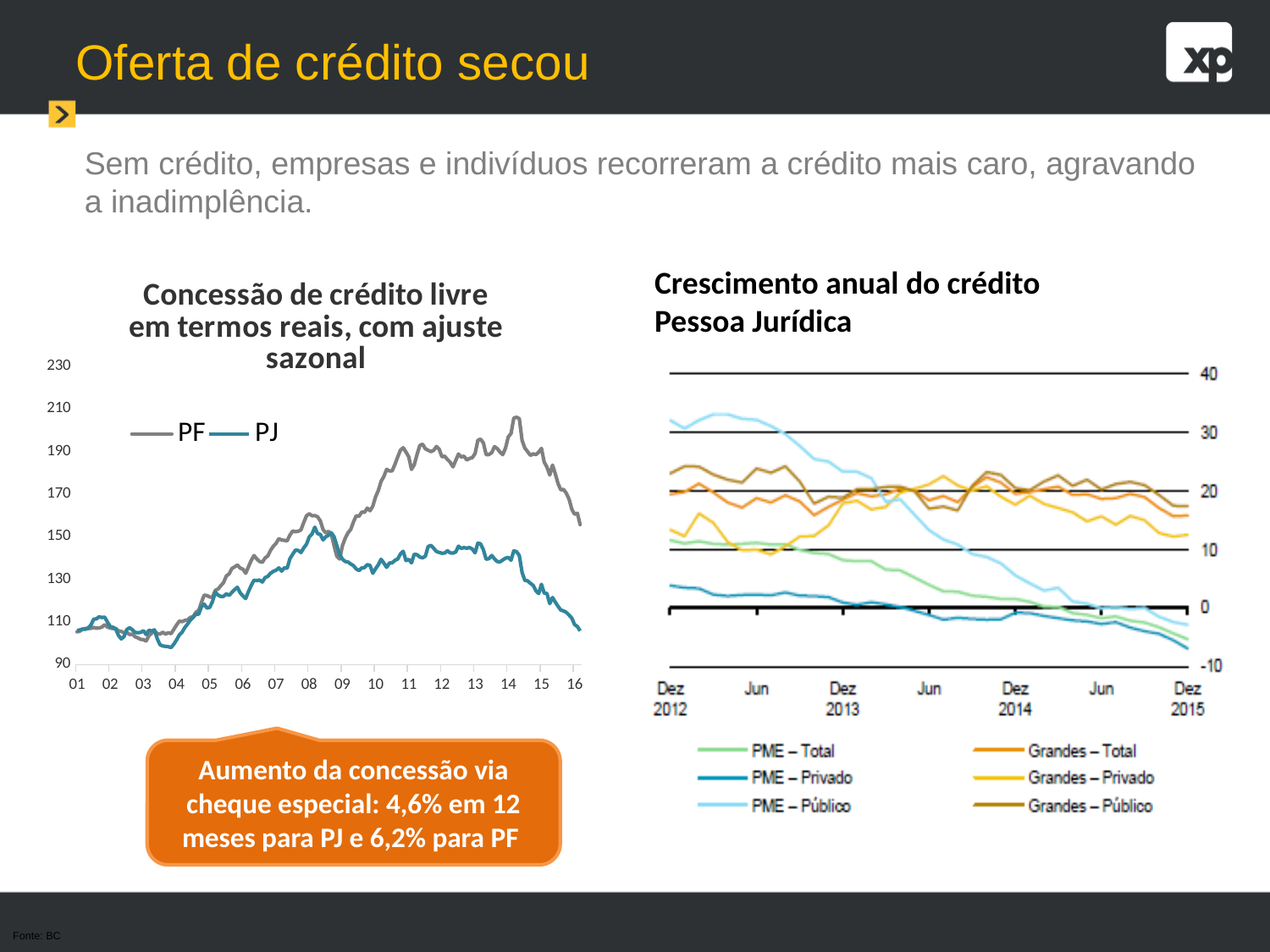
In the left chart 'Concessão de crédito livre', does the PF series rise or fall between 04 and 11? rise In the right chart 'Crescimento anual do crédito Pessoa Jurídica', is the value of PME – Total at Dez 2015 greater or less than 0? less In the right chart 'Crescimento anual do crédito Pessoa Jurídica', does the PME – Público series rise or fall from Dez 2012 to Dez 2015? fall In the left chart 'Concessão de crédito livre', does the PJ series rise or fall between 13 and 16? fall How many series does the legend of the left chart 'Concessão de crédito livre' list? 2 In the right chart 'Crescimento anual do crédito Pessoa Jurídica', is the value of PME – Público at Dez 2012 greater or less than 30? greater In the left chart 'Concessão de crédito livre', which series is higher at the end of the period (16), PF or PJ? PF In the left chart 'Concessão de crédito livre', is the value of the PJ series at the end of the period (16) greater or less than 110? less In the right chart 'Crescimento anual do crédito Pessoa Jurídica', which series is higher at Dez 2015, Grandes – Total or PME – Privado? Grandes – Total What kind of chart is the left chart titled 'Concessão de crédito livre em termos reais, com ajuste sazonal'? line chart How many series does the legend of the right chart 'Crescimento anual do crédito Pessoa Jurídica' list? 6